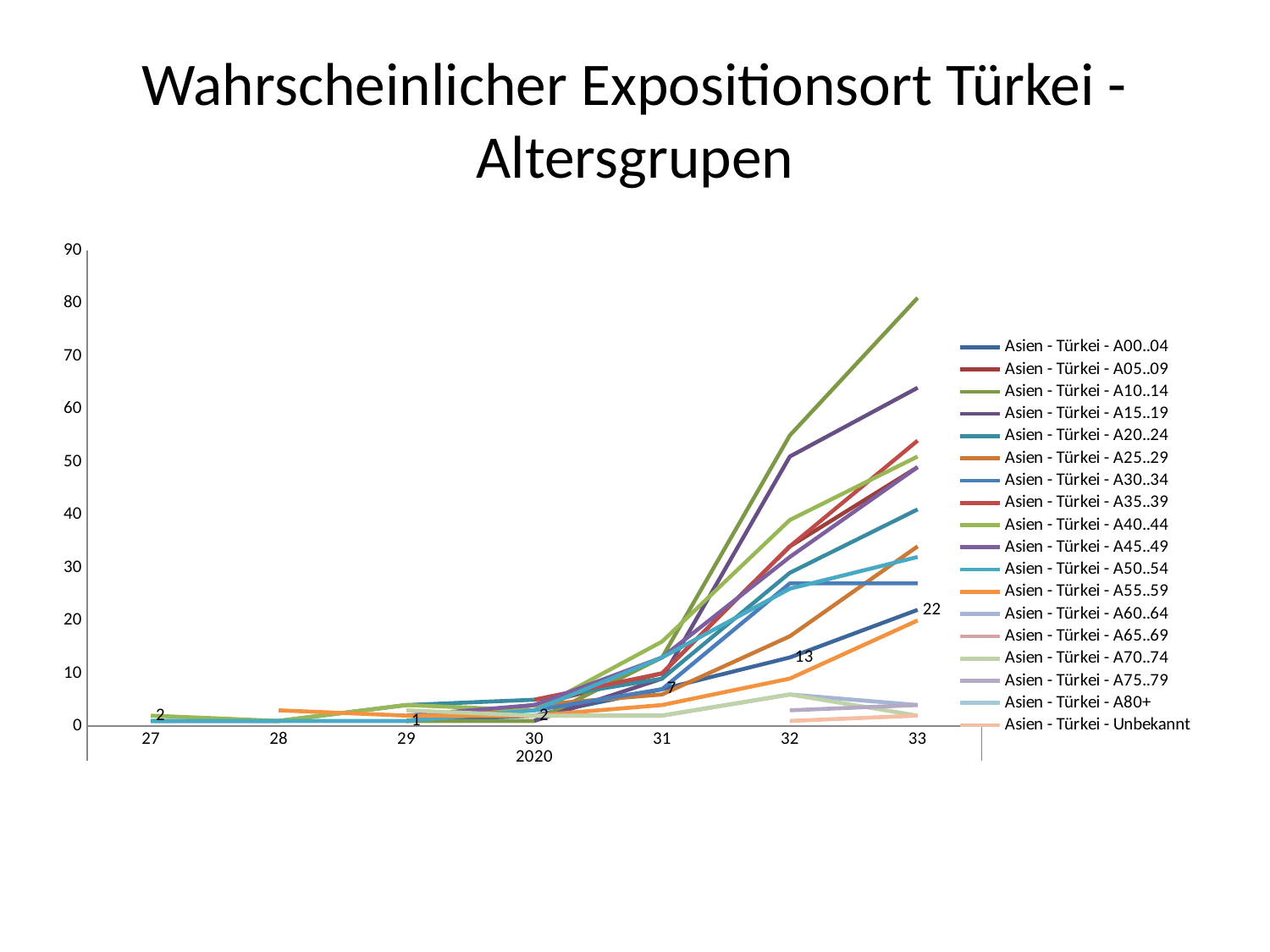
What is the value for Asien - Türkei - A00..04 in week 31? 7 What kind of chart is shown on the slide? line chart How many points are on the x axis (weeks of 2020)? 7 Which series has the highest value in week 33? Asien - Türkei - A10..14 What is the value for Asien - Türkei - A00..04 in week 33? 22 Does the value for Asien - Türkei - A00..04 rise or fall from week 30 to week 33? rise Is the value for Asien - Türkei - A10..14 in week 33 greater or less than 70? greater By how much did the value for Asien - Türkei - A00..04 increase from week 32 to week 33? 9 What is the value for Asien - Türkei - A00..04 in week 32? 13 How many series does the legend list? 18 By how much did the value for Asien - Türkei - A00..04 increase from week 31 to week 32? 6 What is the title of the chart? Wahrscheinlicher Expositionsort Türkei - Altersgrupen